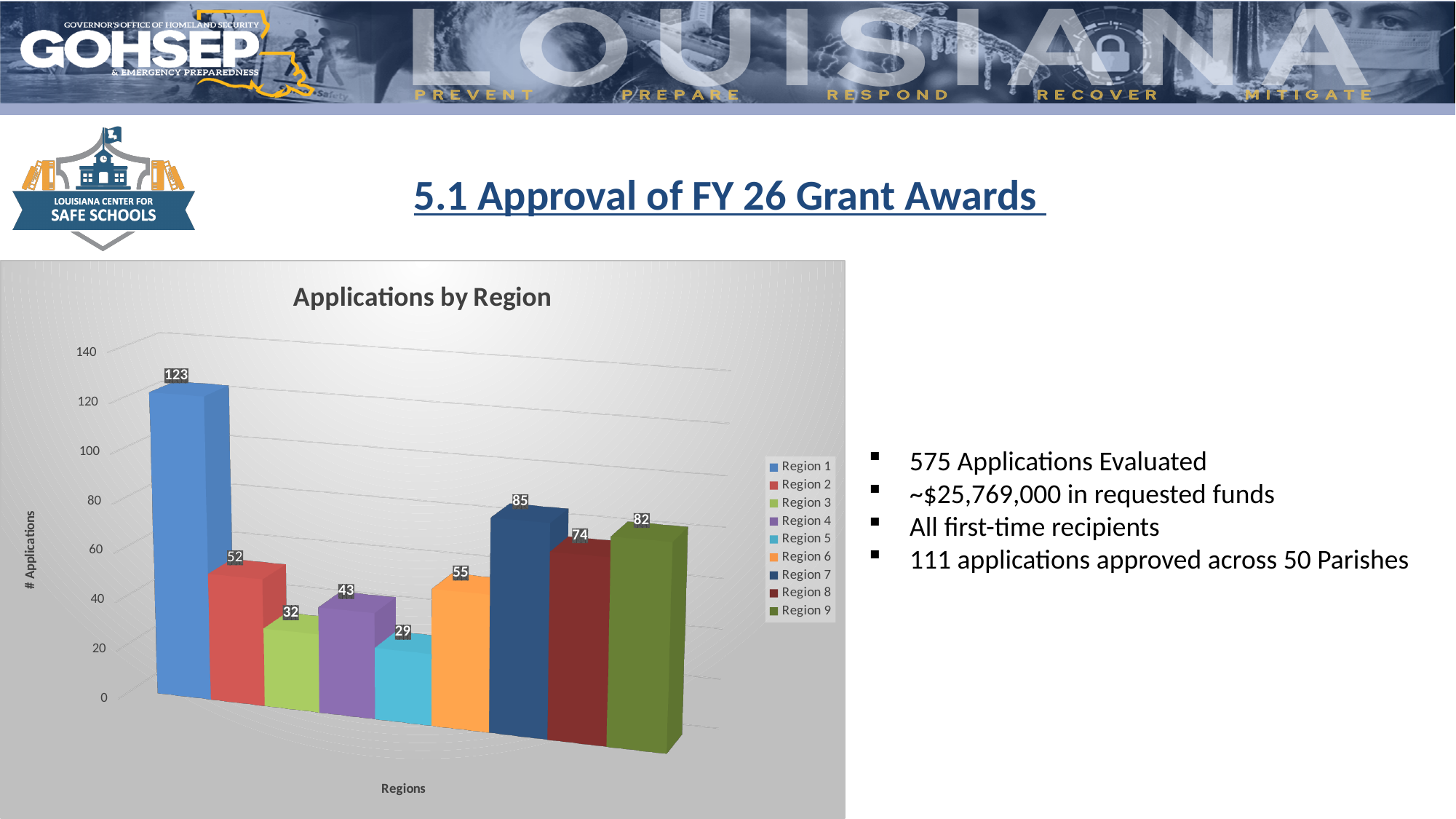
What is the title of the chart? Applications by Region What type of chart is shown on the slide? Bar chart What is the number of applications for Region 5? 29 How many entries does the legend list? 9 Is the value for Region 6 greater or less than 40? greater Which region has the lowest number of applications? Region 5 Which region has the highest number of applications? Region 1 Which has more applications, Region 8 or Region 9? Region 9 What is the number of applications for Region 1? 123 What is the difference in applications between Region 1 and Region 2? 71 How many regions are shown in the chart? 9 What is the number of applications for Region 7? 85